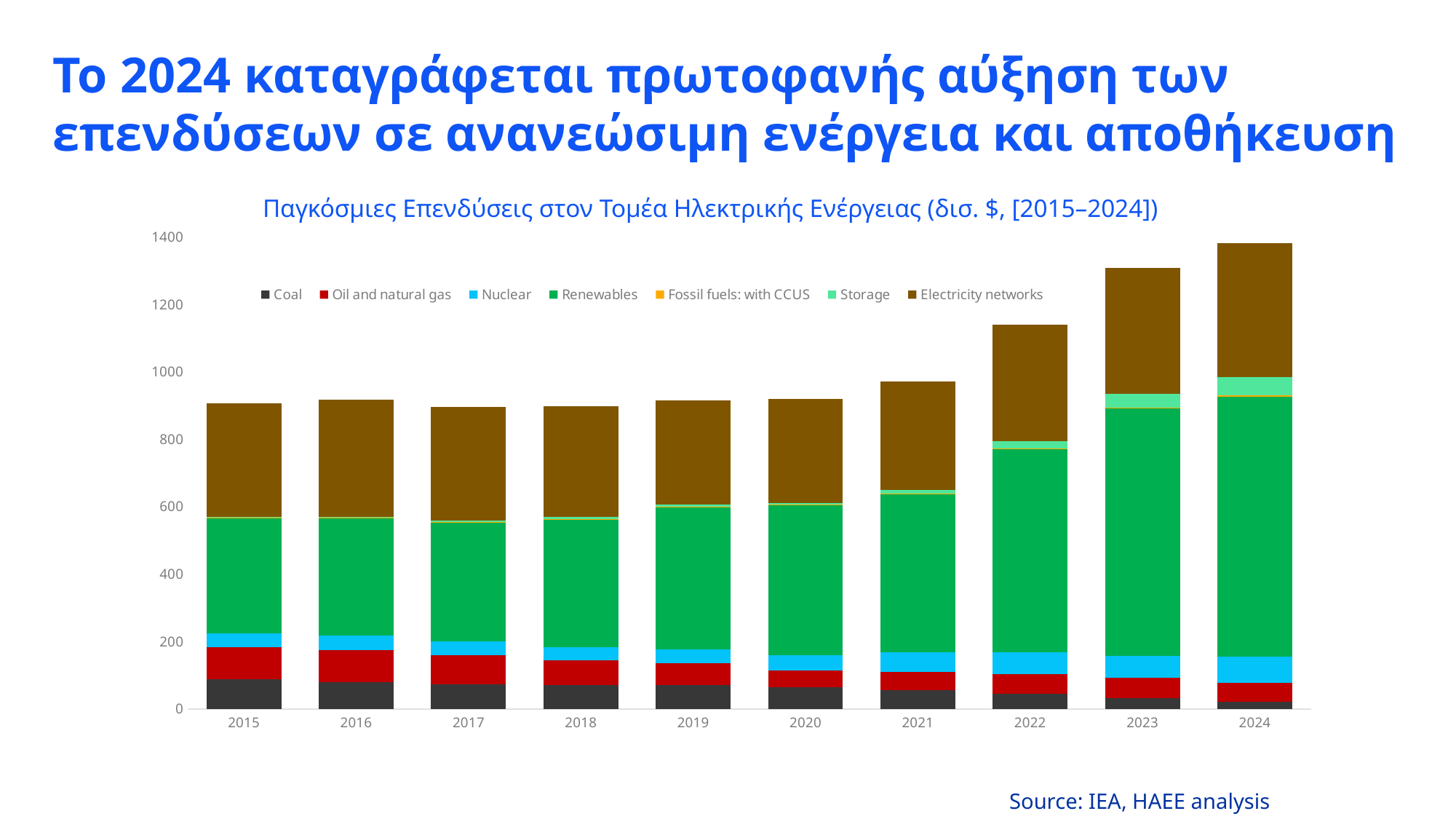
Which legend entry is shown in brown? Electricity networks How many years are shown on the x axis of the chart? 10 What kind of chart is shown on the slide? Stacked bar chart What is the title of the chart? Παγκόσμιες Επενδύσεις στον Τομέα Ηλεκτρικής Ενέργειας (δισ. $, [2015–2024]) Which total bar is larger, 2023 or 2019? 2023 Is the total bar for 2024 greater or less than 1200? greater How many series does the chart legend list? 7 Is the total bar for 2015 greater or less than 1000? less Is the total bar for 2022 greater or less than 1000? greater Which year has the highest total investment bar? 2024 Do the total investment bars generally rise or fall from 2020 to 2024? rise